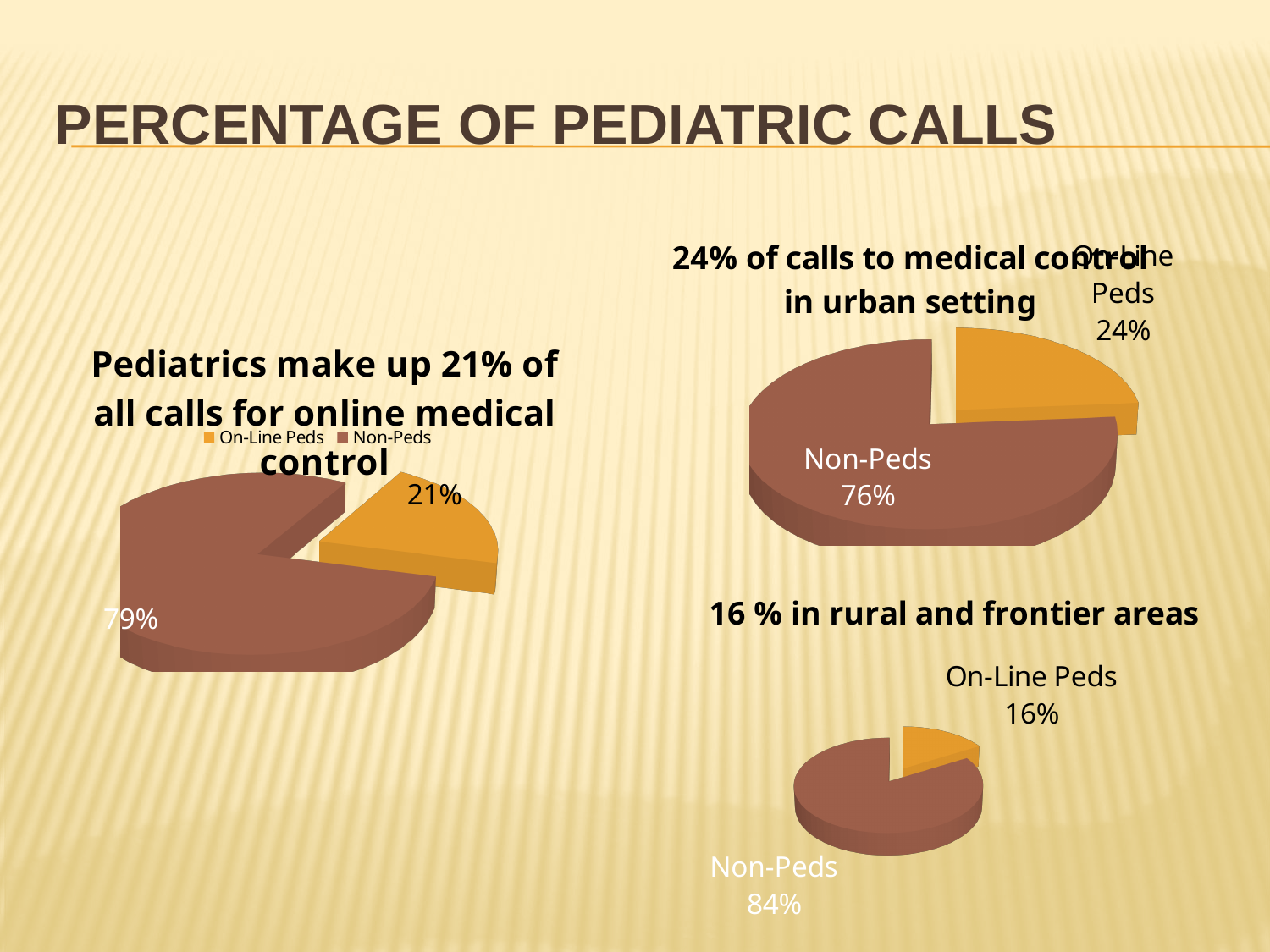
In the chart titled "16 % in rural and frontier areas", which slice is the largest? Non-Peds In the chart titled "Pediatrics make up 21% of all calls for online medical control", what percentage is shown for Non-Peds? 79% In the chart titled "Pediatrics make up 21% of all calls for online medical control", what is the difference between the Non-Peds and On-Line Peds percentages? 58% In the chart titled "24% of calls to medical control in urban setting", which slice is the smallest? On-Line Peds How many entries does the legend of the chart titled "Pediatrics make up 21% of all calls for online medical control" list? 2 In the chart titled "16 % in rural and frontier areas", what percentage is shown for On-Line Peds? 16% In the chart titled "24% of calls to medical control in urban setting", what percentage is shown for Non-Peds? 76% In the chart titled "Pediatrics make up 21% of all calls for online medical control", what percentage is shown for On-Line Peds? 21% What kind of chart is the chart titled "24% of calls to medical control in urban setting"? Pie chart In the chart titled "16 % in rural and frontier areas", what is the difference between the Non-Peds and On-Line Peds percentages? 68% In the chart titled "16 % in rural and frontier areas", what percentage is shown for Non-Peds? 84% How many slices does the chart titled "24% of calls to medical control in urban setting" have? 2